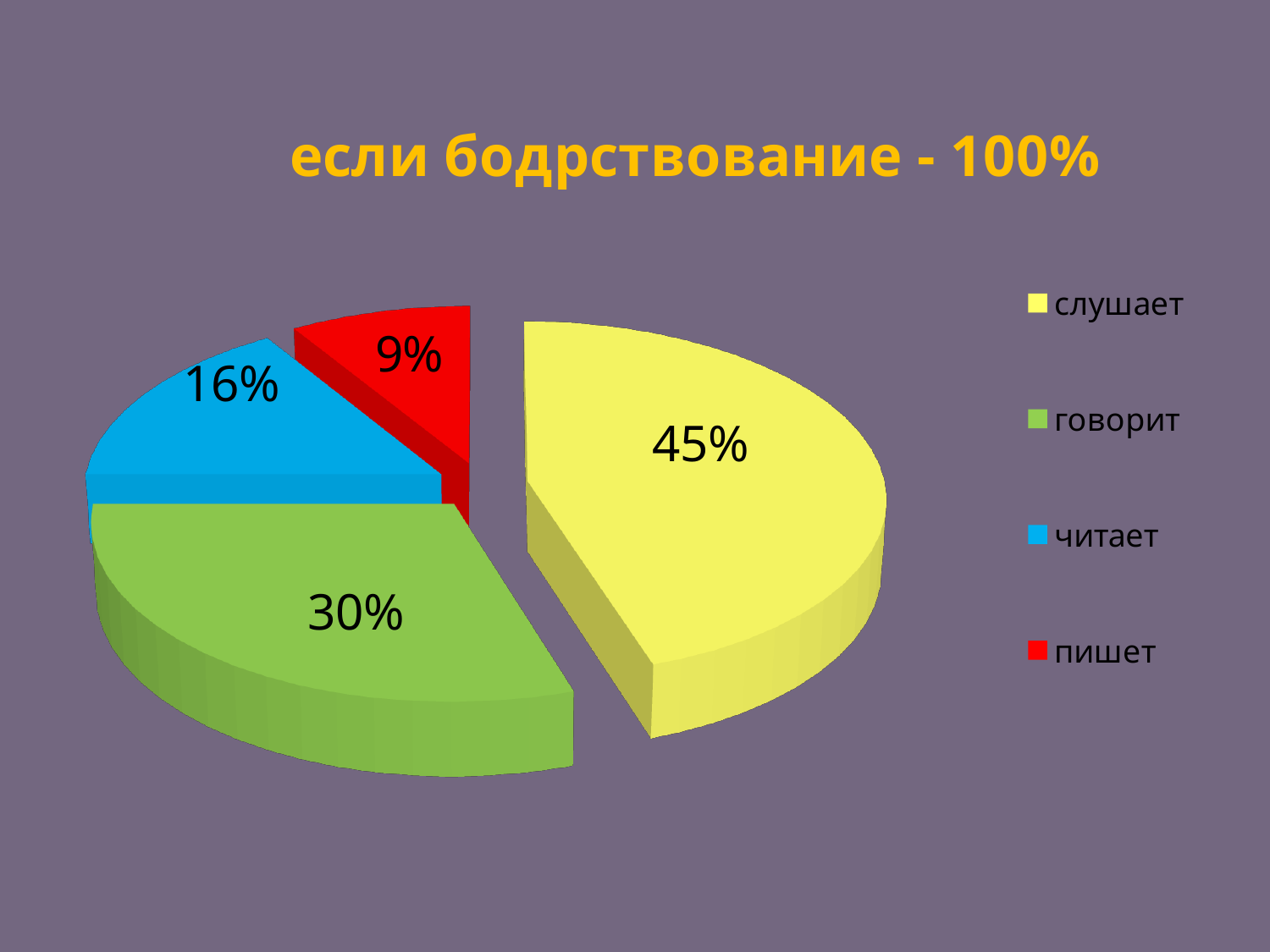
What is the title of the chart? если бодрствование - 100% What is the difference between the values for слушает and говорит? 15% Which category has the smallest share of the pie? пишет What is the value for пишет? 9% Which category has the largest share of the pie? слушает What colour is the slice for читает? blue What is the value for говорит? 30% What is the value for слушает? 45% What is the value for читает? 16% How many slices does the pie chart have? 4 What kind of chart is shown on the slide? pie chart Which is larger, the value for читает or the value for пишет? читает